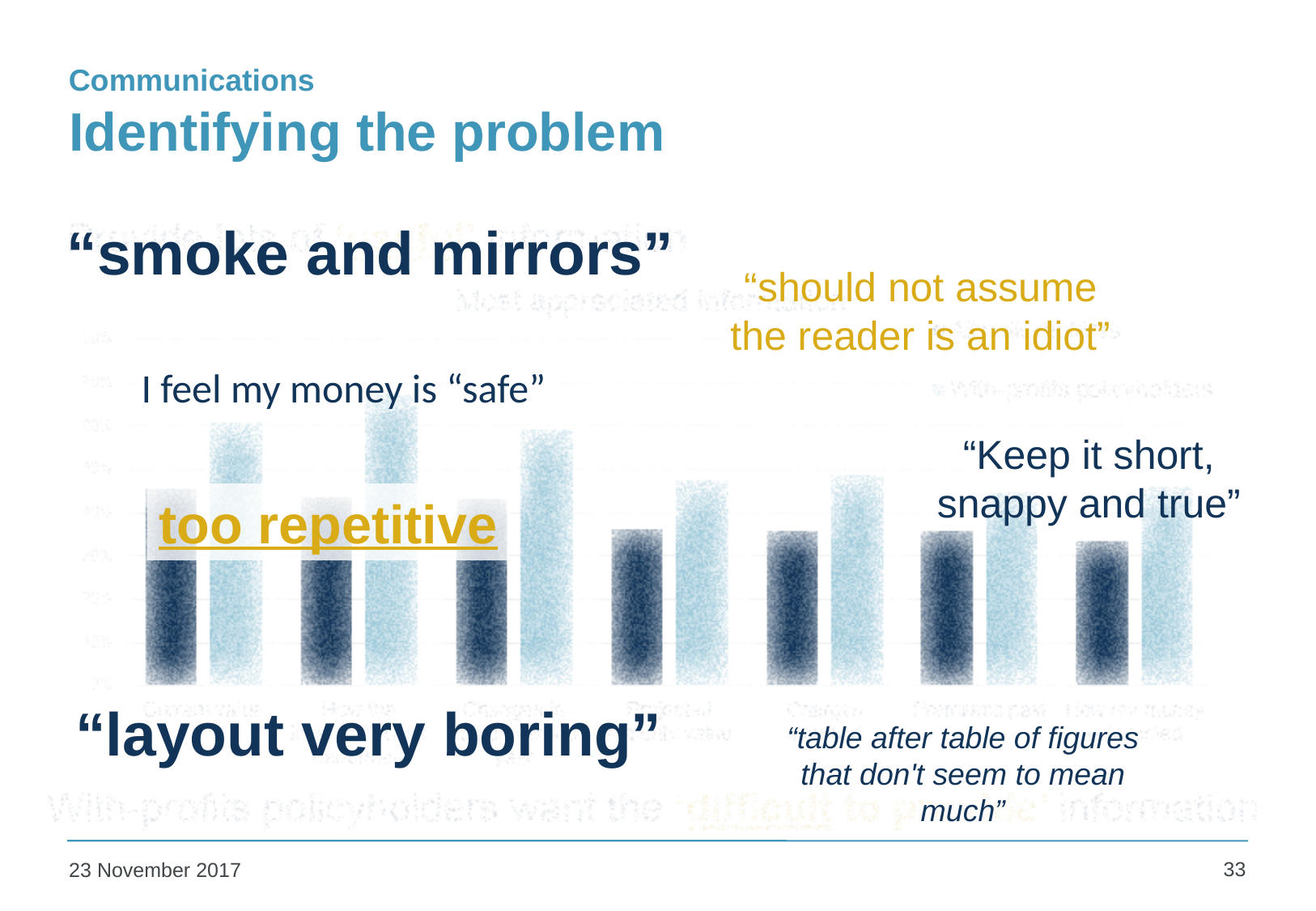
How many differently coloured bar series appear in the background bar chart? 2 In the background bar chart, are the light blue bars or the dark blue bars taller within each group? light blue How many groups of bars does the background bar chart show? 7 What kind of chart is shown in the background of the slide? bar chart How many bars in total are plotted in the background bar chart? 14 What two colours are used for the bars in the background bar chart? dark blue and light blue